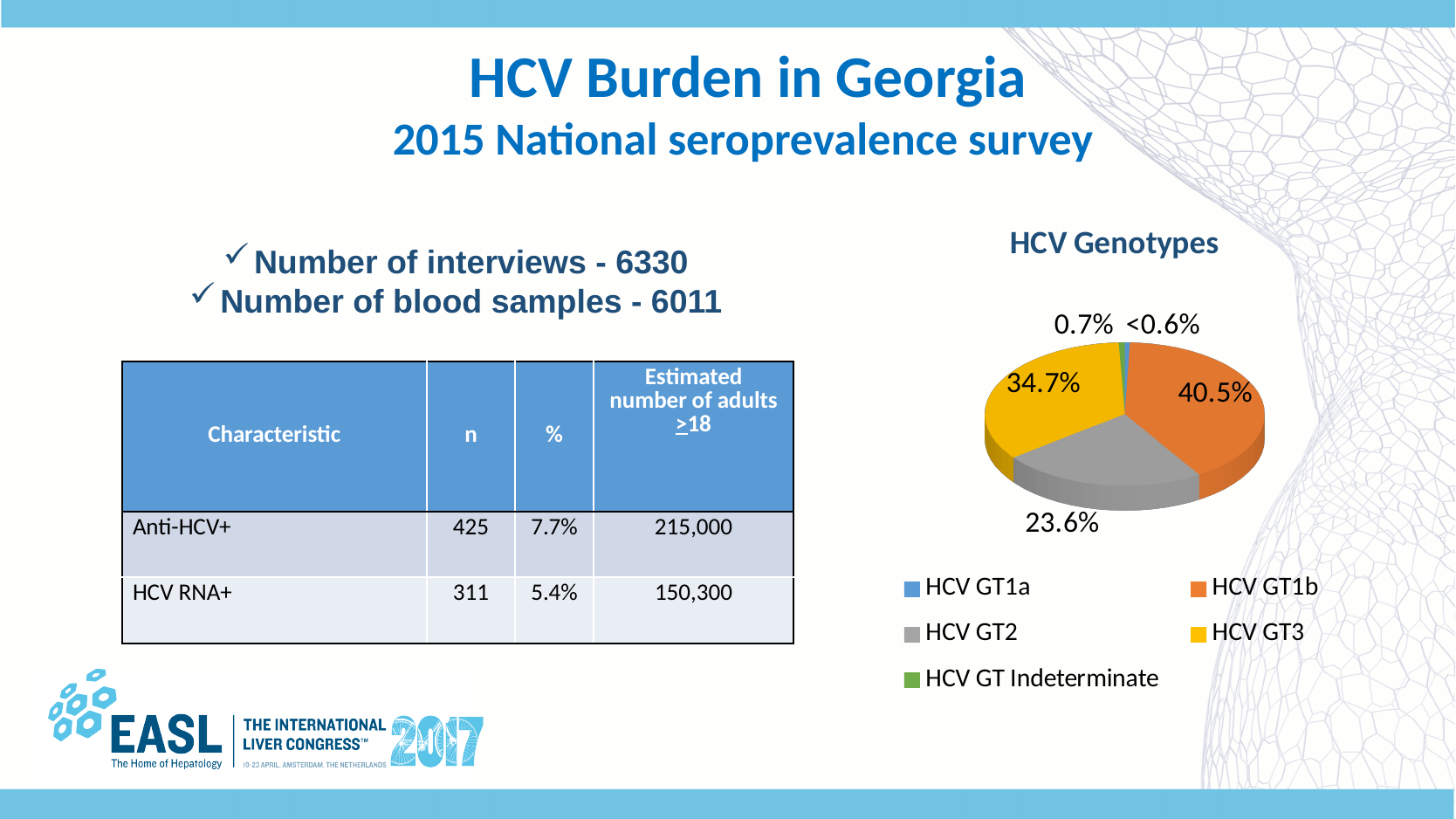
Which genotype has the largest slice in the HCV Genotypes pie chart? HCV GT1b What kind of chart is the HCV Genotypes chart? pie chart What colour represents HCV GT2 in the pie chart? gray How many slices does the HCV Genotypes pie chart have? 5 In the HCV Genotypes pie chart, what share is HCV GT2? 23.6% What is the title of the pie chart on the slide? HCV Genotypes In the HCV Genotypes pie chart, how much larger is the HCV GT1b share than the HCV GT3 share? 5.8% In the HCV Genotypes pie chart, what share is HCV GT3? 34.7% In the HCV Genotypes pie chart, what is the difference between the HCV GT3 and HCV GT2 shares? 11.1% How many entries does the legend of the HCV Genotypes pie chart list? 5 In the HCV Genotypes pie chart, what share is HCV GT1b? 40.5% In the HCV Genotypes pie chart, which is larger: HCV GT3 or HCV GT2? HCV GT3